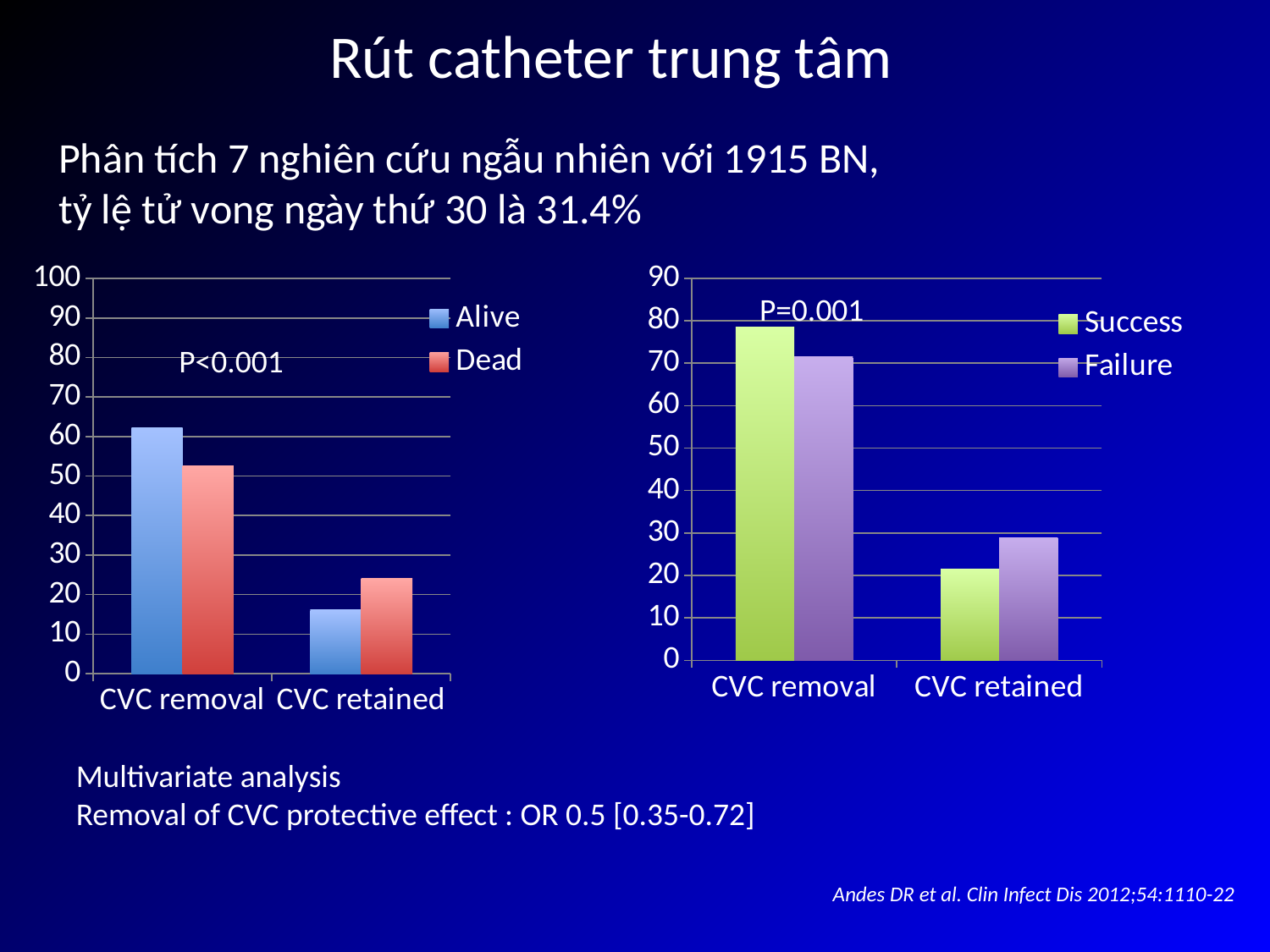
In the right chart, which is larger for CVC removal, Success or Failure? Success What kind of chart is the left chart (with Alive and Dead series)? bar chart In the left chart, is the Alive value for CVC removal greater or less than 50? greater How many series does the legend of the left chart list? 2 In the left chart, is the Alive value for CVC retained greater or less than 20? less In the right chart, which category has the highest Success value? CVC removal In the left chart, which is larger for CVC retained, Alive or Dead? Dead What are the two series named in the legend of the right chart? Success and Failure In the right chart, is the Failure value for CVC retained greater or less than 40? less How many categories are shown on the x axis of the right chart? 2 What P-value annotation is printed on the right chart? P=0.001